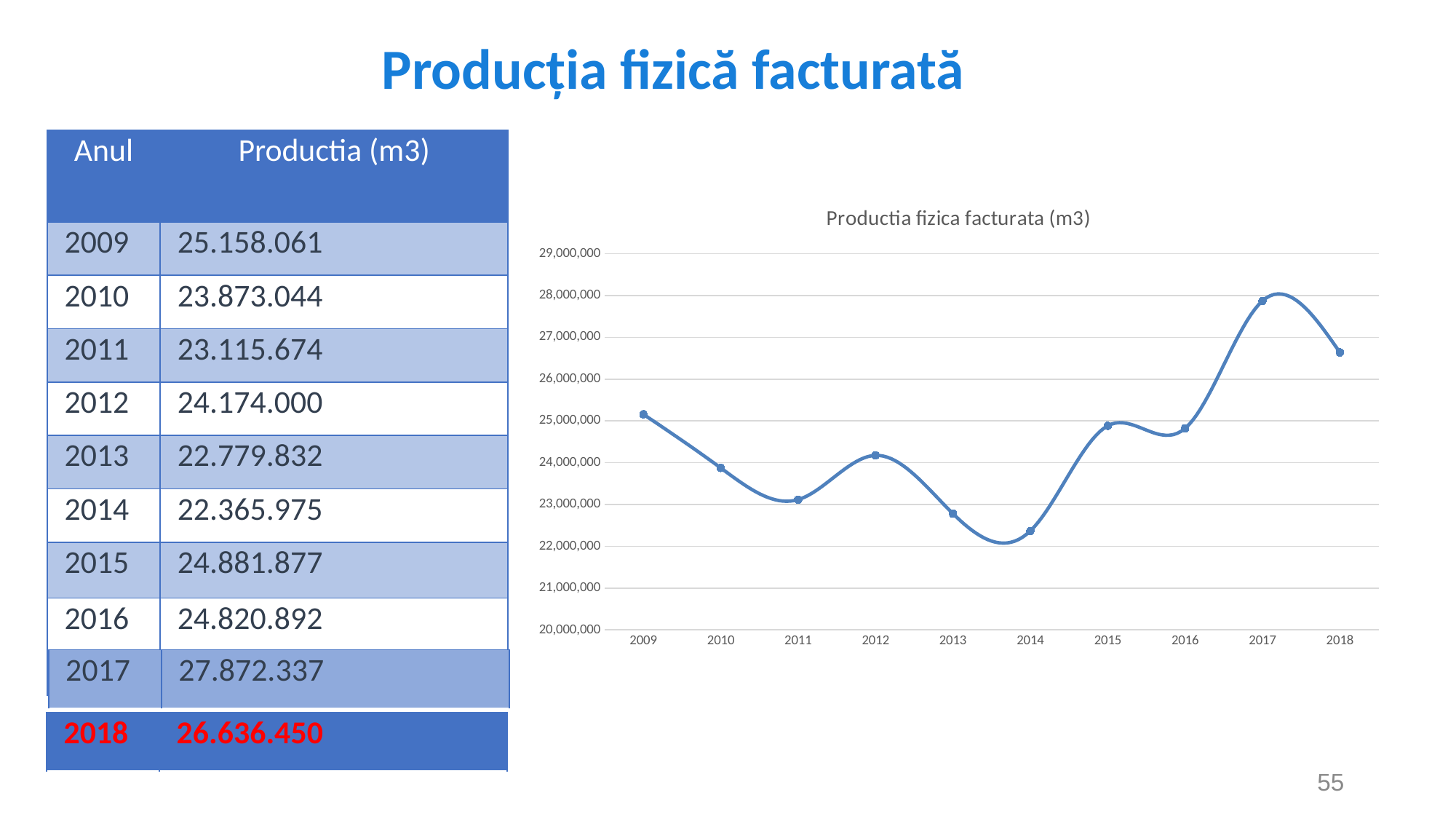
Which year has the lowest production on the chart? 2014 Is the value for 2017 greater or less than 27,000,000? greater What is the production (m3) for 2017? 27.872.337 How many years are plotted on the chart? 10 What kind of chart is shown on the slide? line chart What is the production (m3) for 2018? 26.636.450 Does the production rise or fall from 2014 to 2017? rise Is the value for 2014 greater or less than 23,000,000? less Which is larger, the production in 2009 or in 2010? 2009 What is the production (m3) for 2014? 22.365.975 Which year has the highest production on the chart? 2017 What is the title of the chart? Productia fizica facturata (m3)